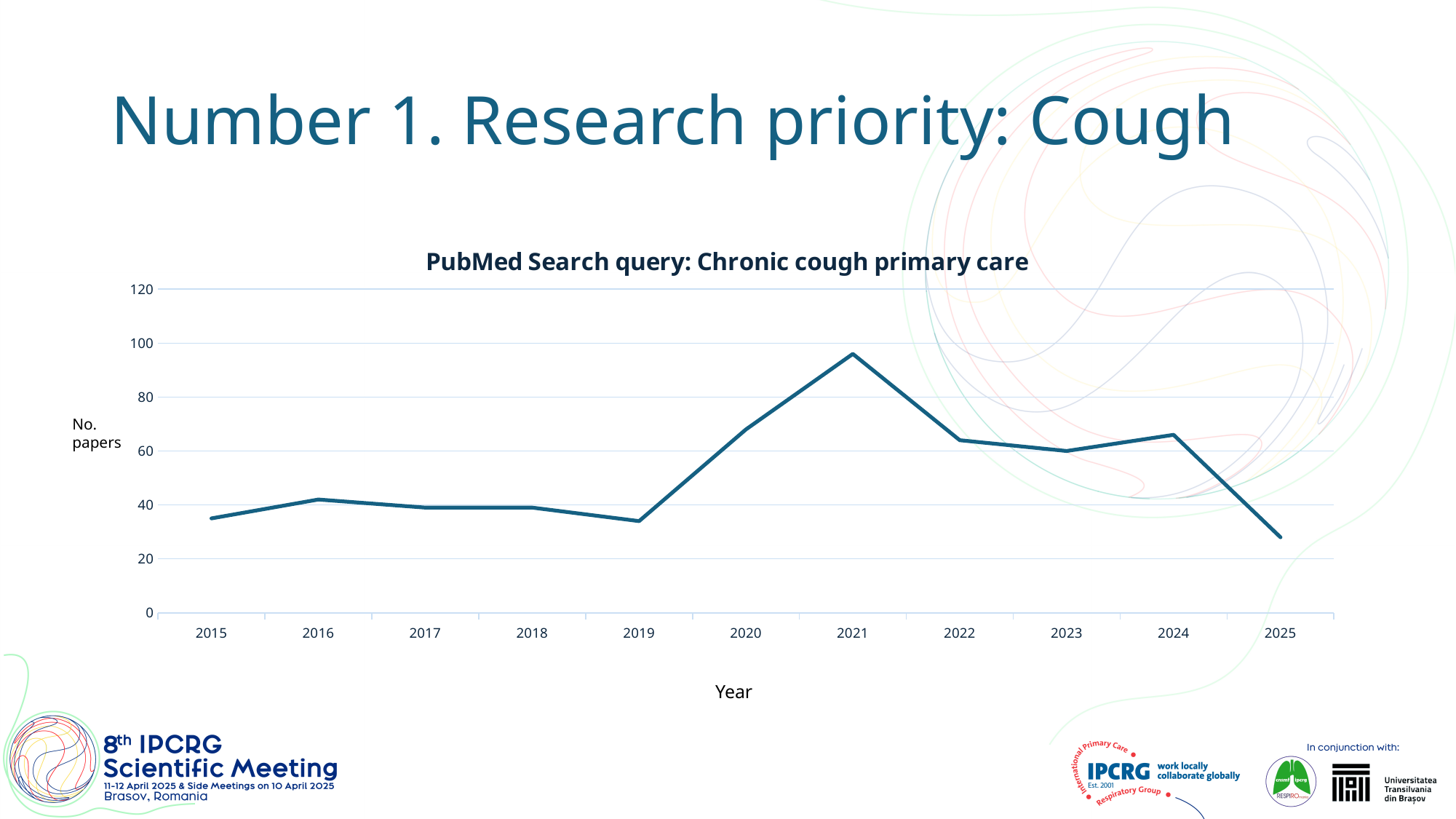
Is the value for 2019 greater or less than 40? less Is the value for 2025 greater or less than 40? less Is the value for 2021 greater or less than 80? greater What kind of chart is shown on the slide? line chart Which year has the lowest number of papers? 2025 Which year has the highest number of papers? 2021 Which year has more papers, 2016 or 2019? 2016 What is the title of the chart? PubMed Search query: Chronic cough primary care Do the values rise or fall from 2019 to 2021? rise What is the label on the vertical axis of the chart? No. papers How many years are plotted on the x axis of the chart? 11